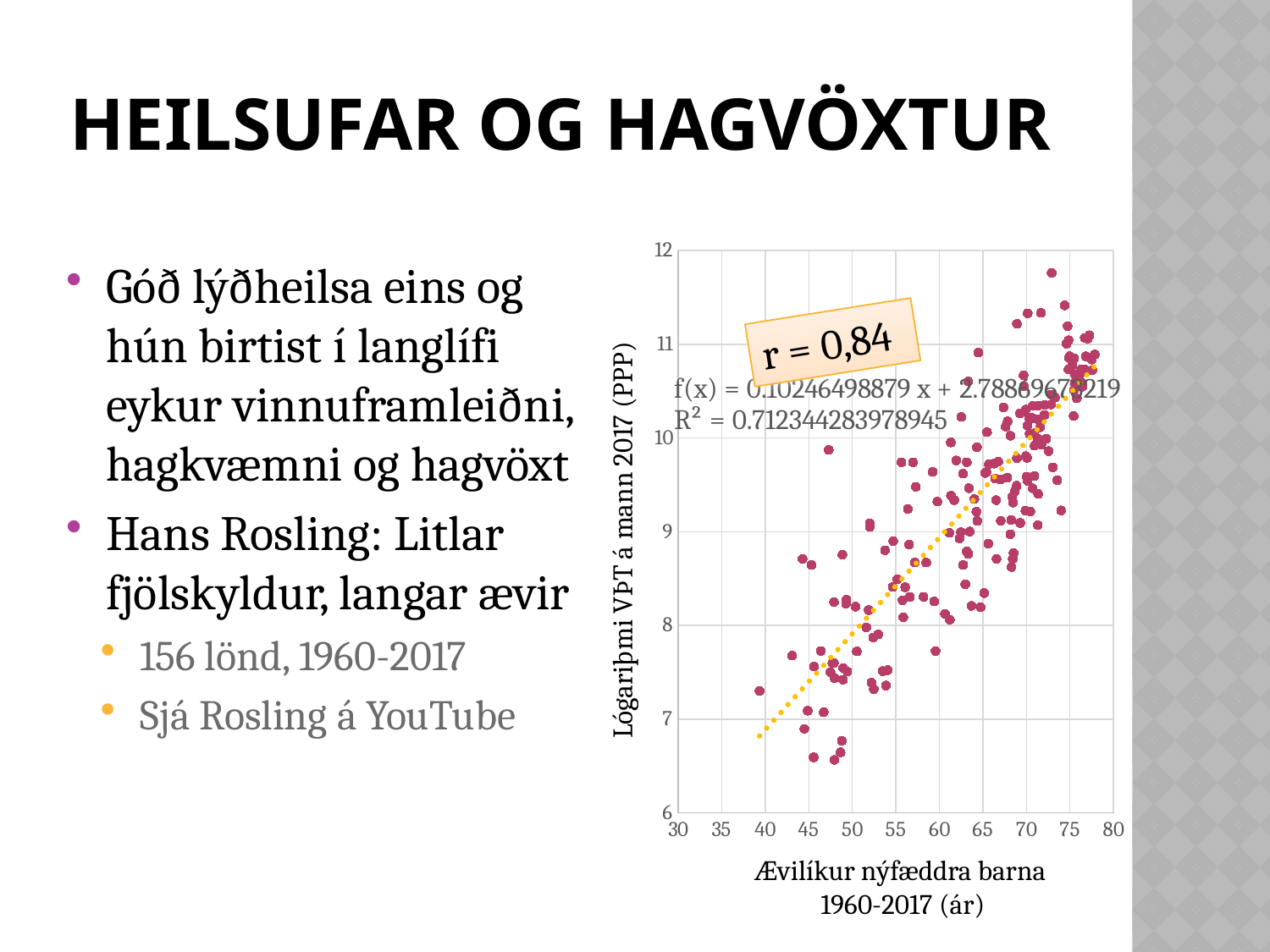
Is the trendline's value at x = 75 greater or less than 10? greater Do the plotted points generally rise or fall as life expectancy (the x axis) increases? rise What kind of chart is shown on the slide? scatter chart What is the maximum value shown on the x axis? 80 What correlation coefficient r is shown in the box on the chart? r = 0,84 What is the minimum value shown on the y axis? 6 Is the y value of the highest point on the chart greater or less than 11? greater What is the slope (coefficient of x) in the trendline equation printed on the chart? 0.10246498879 Is the y value of the lowest point on the chart greater or less than 7? less What R² value is printed on the chart? 0.712344283978945